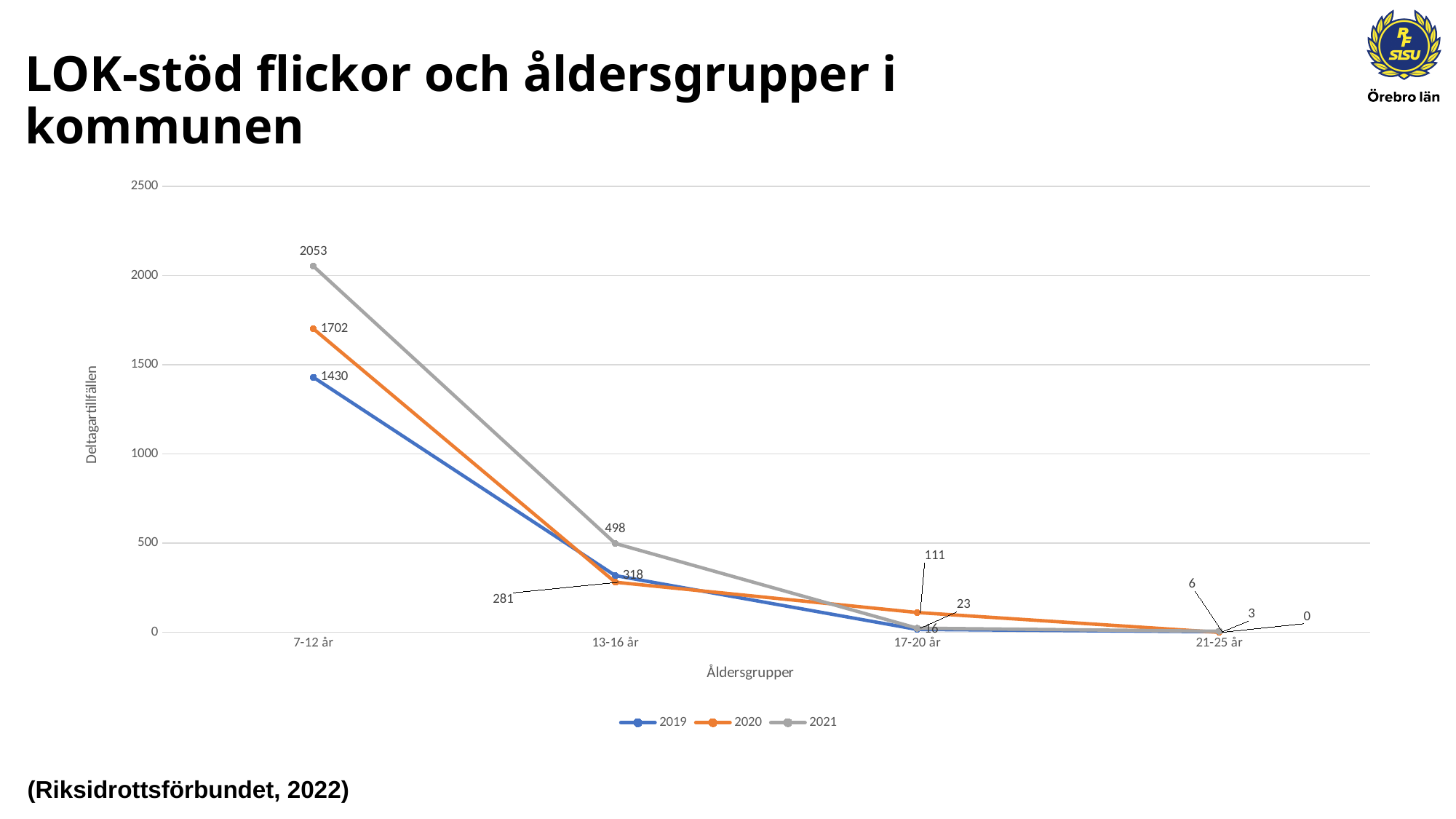
What is the value for 2019 in the 7-12 år age group? 1430 What is the difference between the 2021 and 2019 values in the 13-16 år age group? 180 How many age groups are shown on the x axis? 4 What is the value for 2020 in the 13-16 år age group? 281 How many series does the legend list? 3 What is the value for 2020 in the 17-20 år age group? 111 Which year has the highest value in the 7-12 år age group? 2021 What kind of chart is shown on the slide? line chart What is the value for 2021 in the 7-12 år age group? 2053 Do the values for 2021 rise or fall as the age groups increase along the x axis? fall What is the difference between the 2021 and 2020 values in the 7-12 år age group? 351 In the 13-16 år age group, which is larger: the value for 2019 or for 2020? 2019